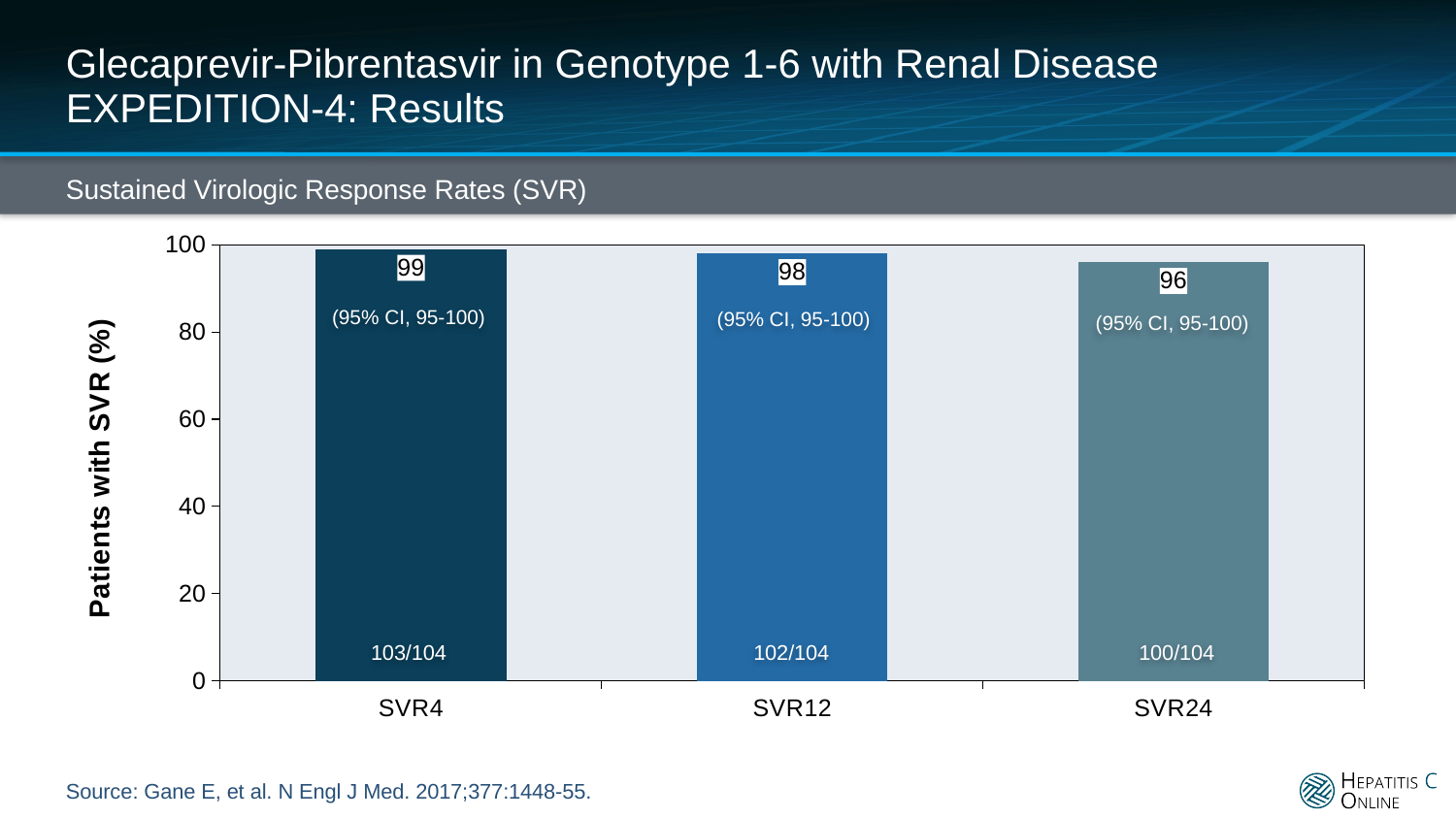
What is the value for SVR4? 99 What is the value for SVR24? 96 What kind of chart is shown? bar chart What is the y-axis label of the chart? Patients with SVR (%) How many categories are shown on the x axis? 3 Which is larger, the value for SVR12 or the value for SVR24? SVR12 Do the values rise or fall from SVR4 to SVR24? fall Is the value for SVR24 greater or less than 80? greater Which category has the lowest value? SVR24 What is the difference between the values for SVR4 and SVR24? 3 What is the value for SVR12? 98 Which category has the highest value? SVR4